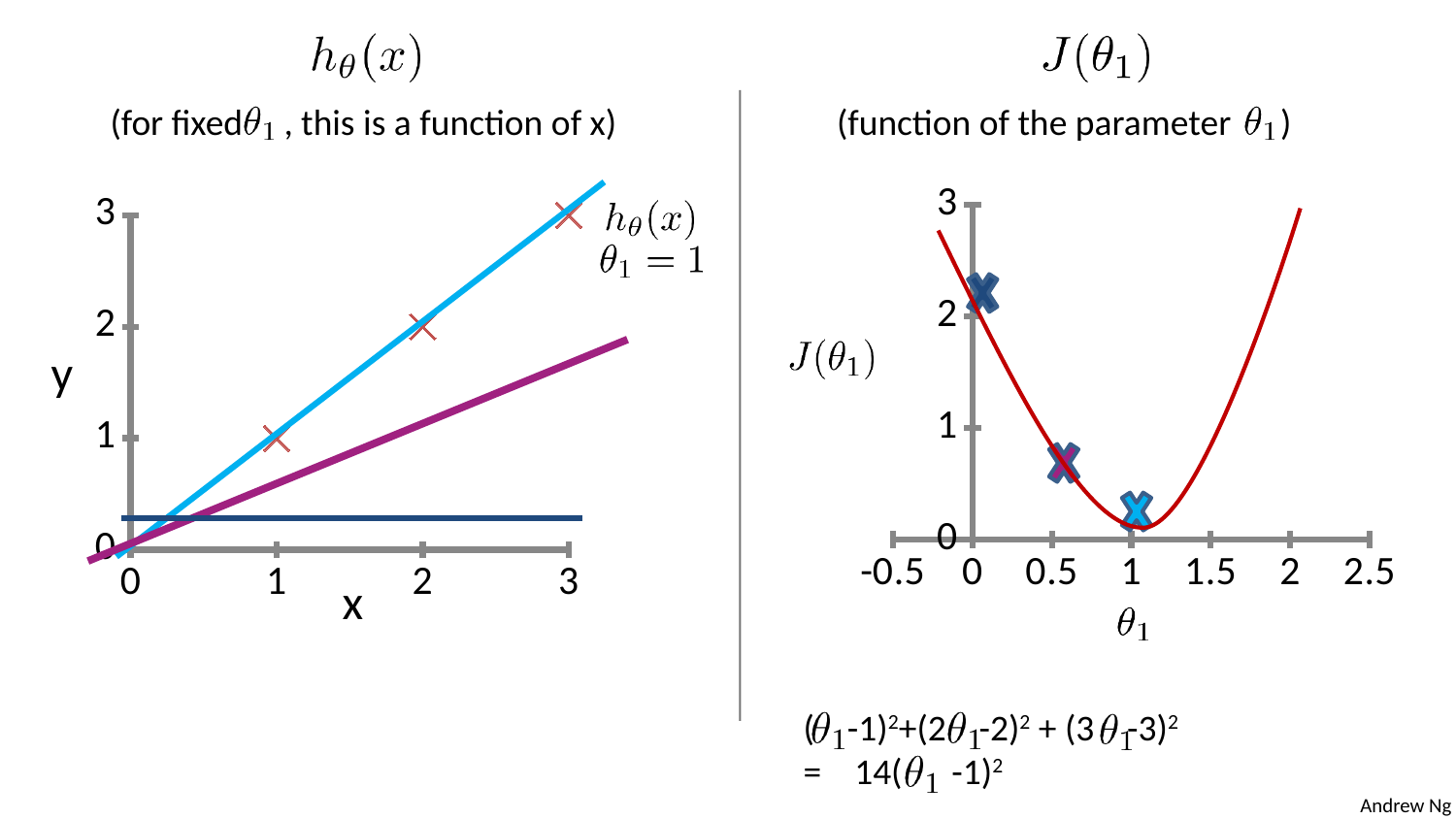
In the left chart titled h_θ(x), what is the y value of the data point at x = 3? 3 In the right chart titled J(θ1), what is the label of the horizontal axis? θ1 In the left chart titled h_θ(x), do the red data points rise or fall as x increases? rise In the right chart titled J(θ1), is the value of the marked point near θ1 = 0.5 greater or less than 1? less In the right chart titled J(θ1), is the value of the marked point near θ1 = 0 greater or less than 2? greater In the right chart titled J(θ1), how many x markers are placed on the curve? 3 In the right chart titled J(θ1), at which value of θ1 does the curve reach its minimum? 1 In the left chart titled h_θ(x), how many red x data points are plotted? 3 In the left chart titled h_θ(x), which data point has the highest y value, the one at x = 1 or the one at x = 3? x = 3 In the left chart titled h_θ(x), what is the label of the vertical axis? y In the left chart titled h_θ(x), what is the y value of the data point at x = 2? 2 In the left chart titled h_θ(x), how many straight lines are drawn through the plot? 3